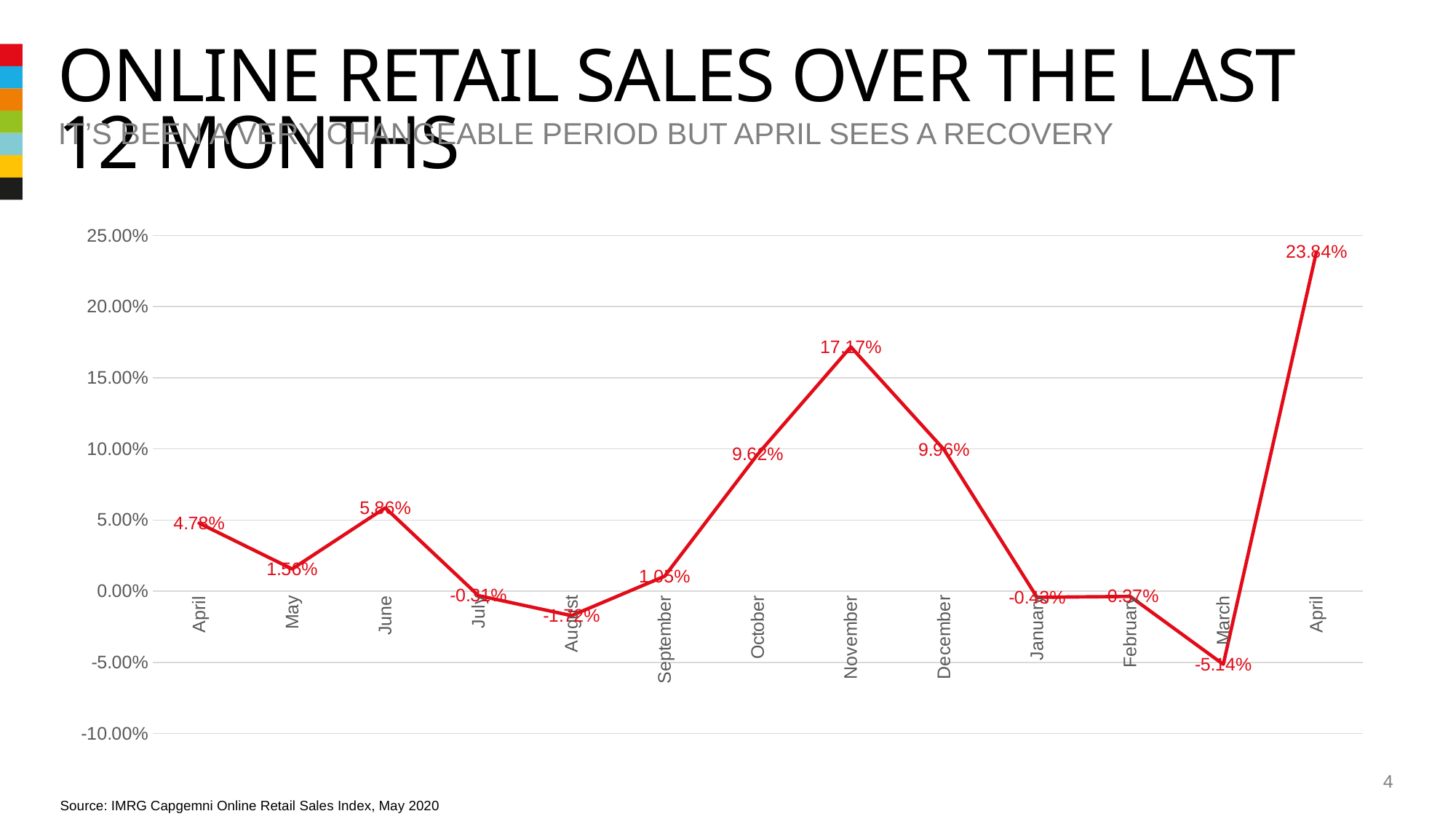
Which month has the highest value on the chart? April (the final, rightmost point) Is the value for November greater or less than 15.00%? greater How many data points are plotted on the line? 13 What is the value for March? -5.14% What is the value for October? 9.62% What kind of chart is shown on the slide? Line chart Which is larger, the value for June or the value for May? June What is the value for the final April (rightmost point)? 23.84% Which month has the lowest value on the chart? March Do the values rise or fall from November to March? Fall What is the value for November? 17.17% What is the difference between the November value and the December value? 7.21 percentage points